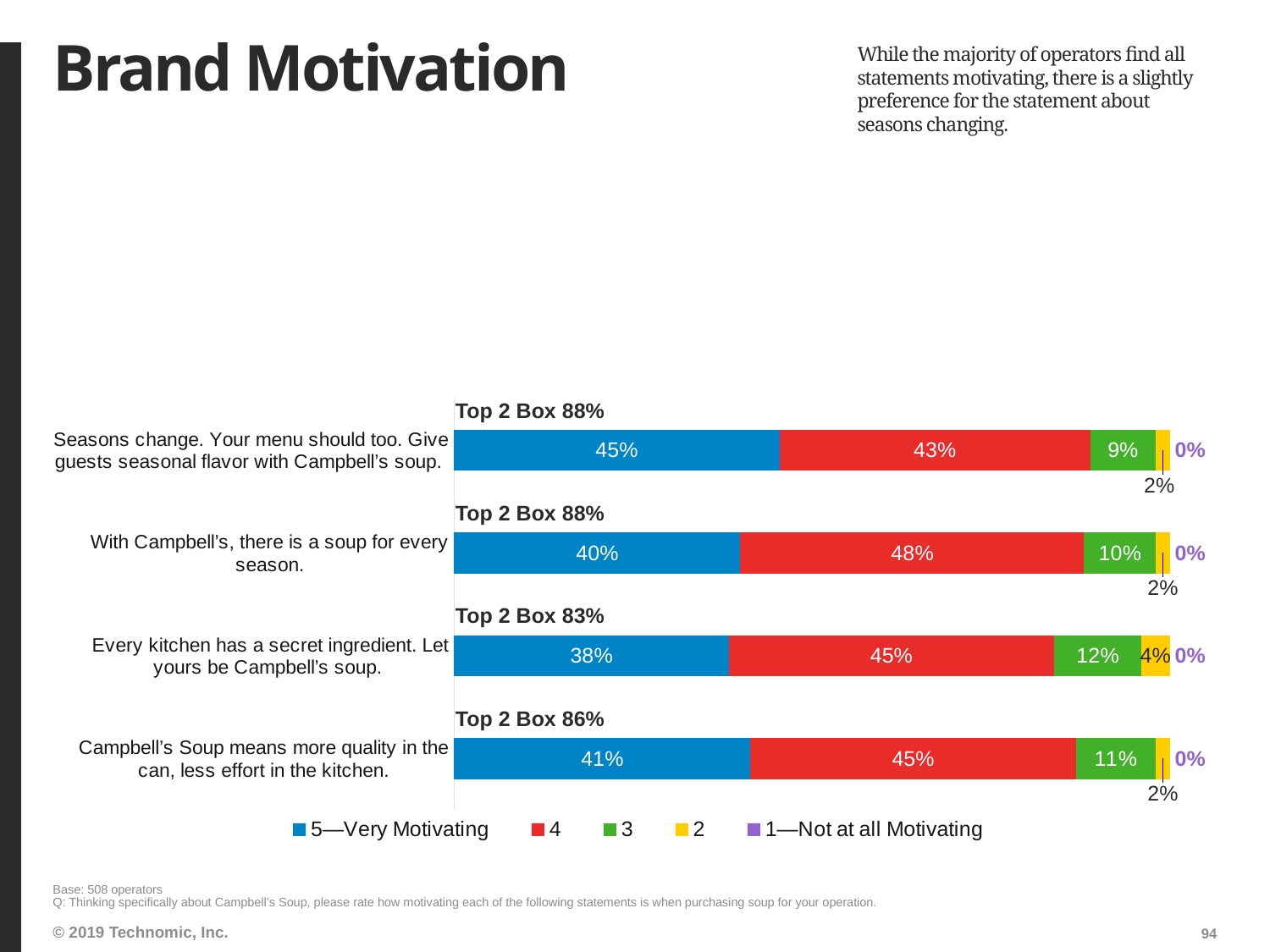
Which statement has the highest share of 5—Very Motivating ratings? Seasons change. Your menu should too. Give guests seasonal flavor with Campbell's soup. How many series does the legend list? 5 What is the difference between the 4 rating and the 5—Very Motivating rating for "With Campbell's, there is a soup for every season."? 8 percentage points What is the Top 2 Box score for "Every kitchen has a secret ingredient. Let yours be Campbell's soup."? 83% What percentage rated "Campbell's Soup means more quality in the can, less effort in the kitchen." as 3? 11% What percentage of operators rated "Seasons change. Your menu should too. Give guests seasonal flavor with Campbell's soup." as 5—Very Motivating? 45% Which statement has the lowest share of 5—Very Motivating ratings? Every kitchen has a secret ingredient. Let yours be Campbell's soup. What percentage rated "With Campbell's, there is a soup for every season." as 4? 48% Which is larger: the 3 rating for "Every kitchen has a secret ingredient" or the 3 rating for "Seasons change. Your menu should too"? Every kitchen has a secret ingredient (12%) How many statements (categories) are plotted in the chart? 4 What kind of chart is shown on the slide? Stacked bar chart What is the label of the last series in the legend? 1—Not at all Motivating